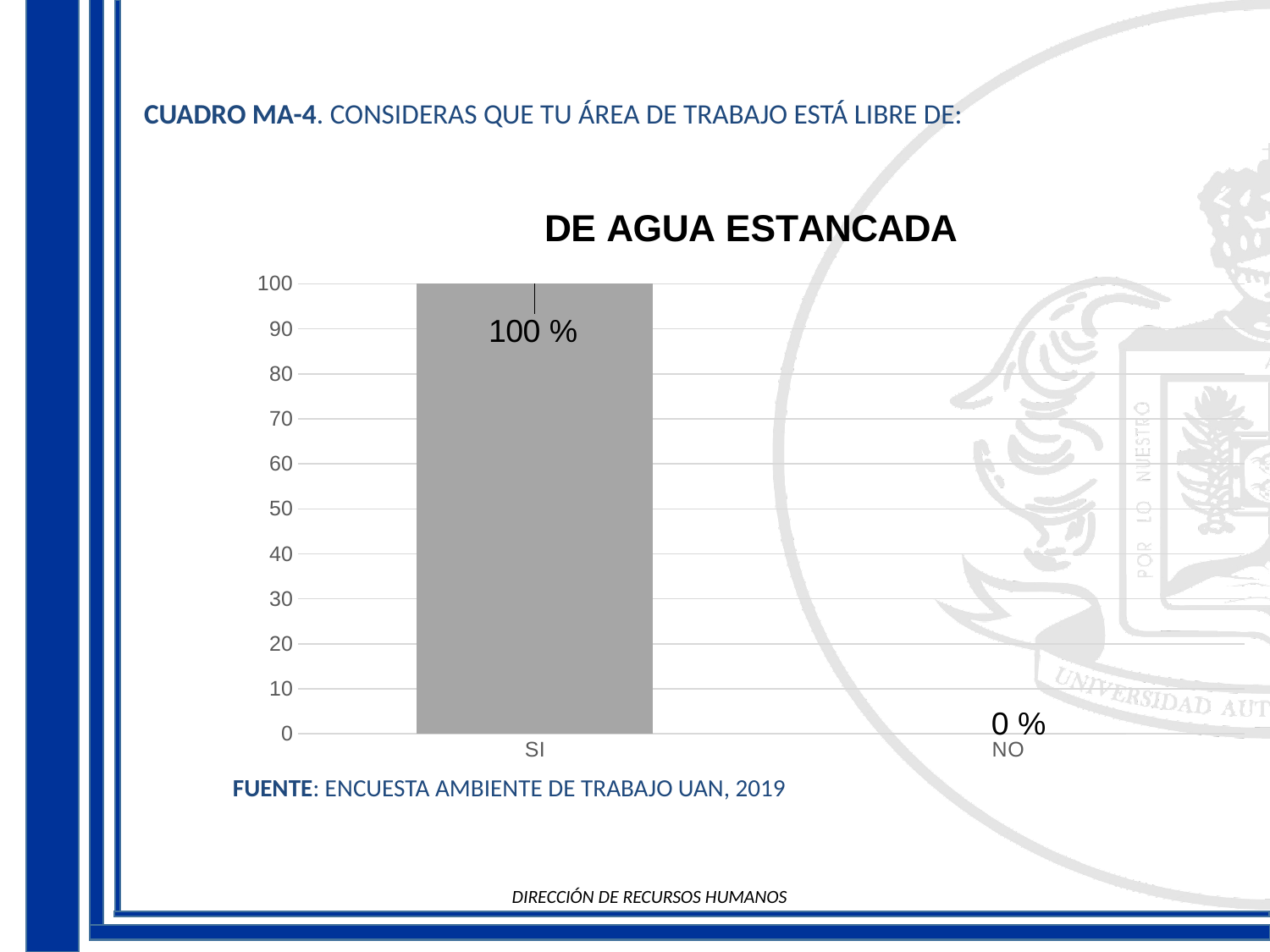
What is the difference between the values for SI and NO? 100 % How many categories are shown on the x axis? 2 Which category has the lowest value? NO What is the maximum value shown on the y axis? 100 Is the value for SI greater or less than 50? greater What kind of chart is shown? bar chart What is the title of the chart? DE AGUA ESTANCADA What is the value for NO? 0 % What is the value for SI? 100 % Which is larger, the value for SI or the value for NO? SI Do the values rise or fall from SI to NO along the x axis? fall Which category has the highest value? SI